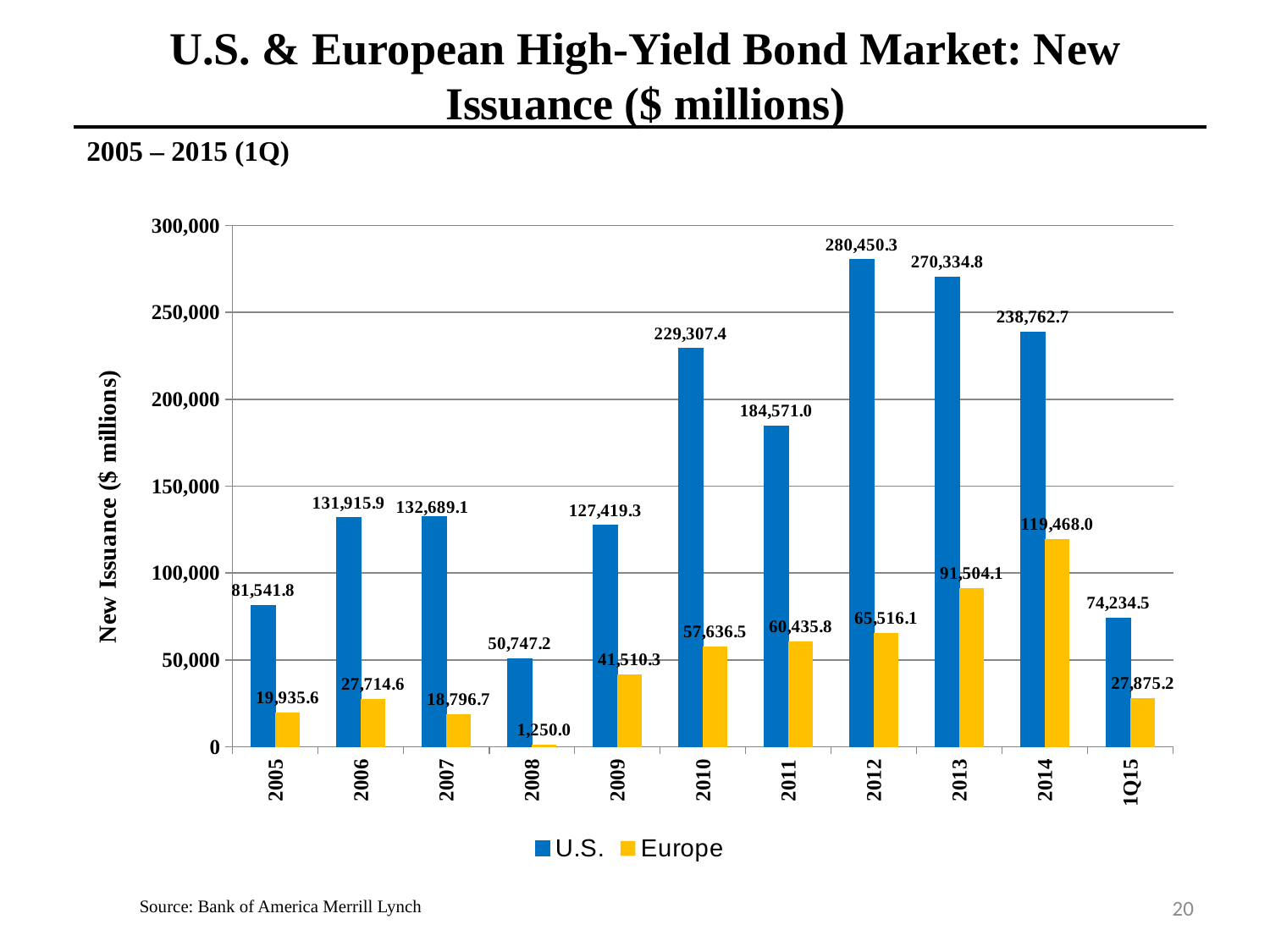
How many time periods are shown on the x axis? 11 What is the difference between U.S. new issuance in 2012 and 2013? 10,115.5 What was the Europe new issuance in 2014? 119,468.0 How many series does the legend list? 2 Which year had higher Europe new issuance, 2010 or 2011? 2011 What is the difference between U.S. and Europe new issuance in 2014? 119,294.7 In which year was Europe new issuance lowest? 2008 Is the U.S. new issuance for 2011 greater or less than 200,000? less In which year was U.S. new issuance highest? 2012 What was the U.S. new issuance in 2012? 280,450.3 What was the Europe new issuance in 2008? 1,250.0 What kind of chart is shown on the slide? bar chart